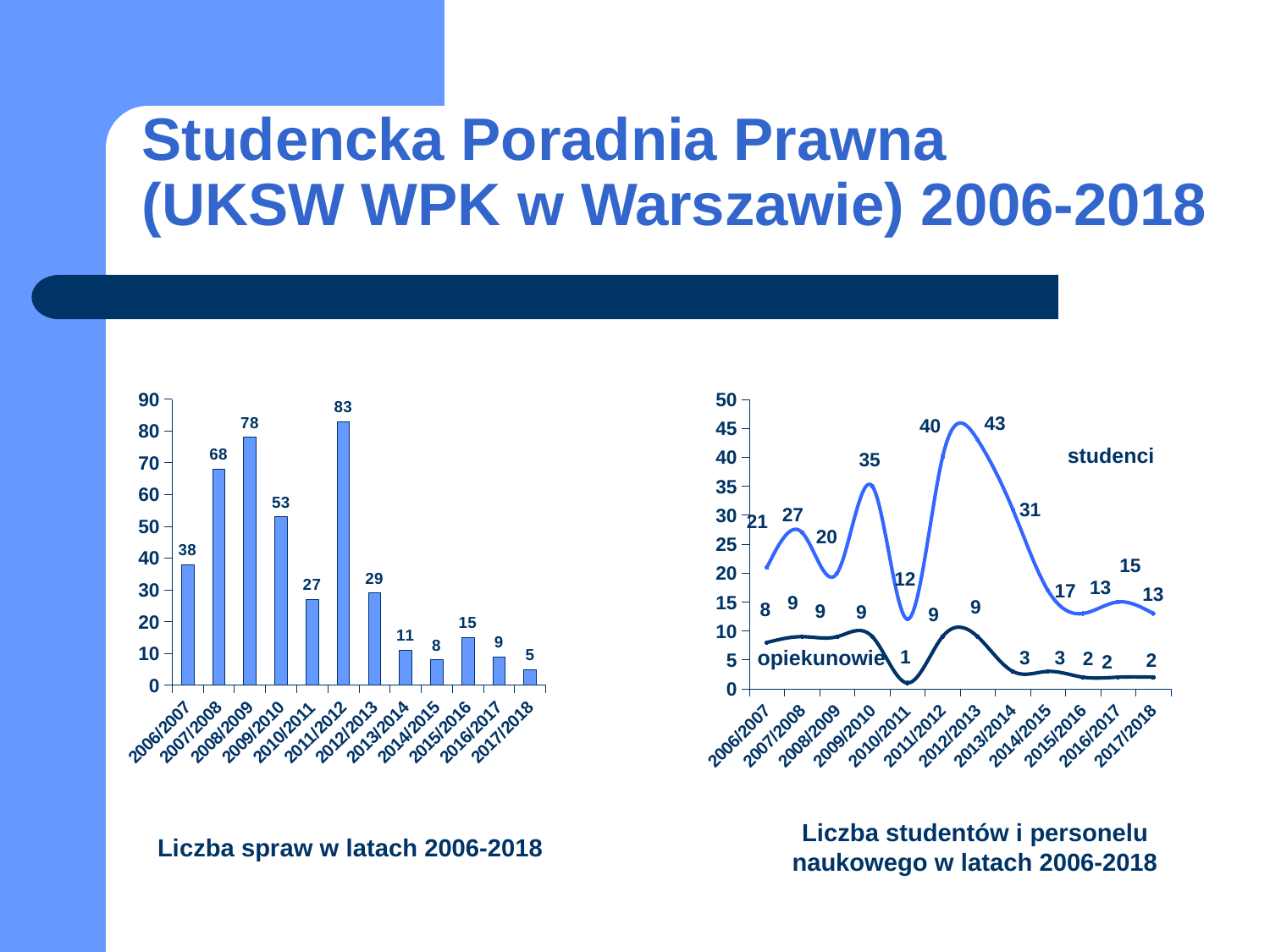
In the chart 'Liczba studentów i personelu naukowego w latach 2006-2018', which is larger in 2009/2010: studenci or opiekunowie? studenci What type of chart is 'Liczba spraw w latach 2006-2018'? bar chart In the chart 'Liczba spraw w latach 2006-2018', which year has the highest value? 2011/2012 In the chart 'Liczba studentów i personelu naukowego w latach 2006-2018', what is the difference between studenci and opiekunowie in 2013/2014? 28 In the chart 'Liczba studentów i personelu naukowego w latach 2006-2018', in which year is the studenci value highest? 2012/2013 What type of chart is 'Liczba studentów i personelu naukowego w latach 2006-2018'? line chart In the chart 'Liczba spraw w latach 2006-2018', what is the difference between the values for 2008/2009 and 2009/2010? 25 In the chart 'Liczba studentów i personelu naukowego w latach 2006-2018', what is the value for opiekunowie in 2010/2011? 1 In the chart 'Liczba spraw w latach 2006-2018', how many years are shown on the x axis? 12 In the chart 'Liczba spraw w latach 2006-2018', which year has the lowest value? 2017/2018 In the chart 'Liczba spraw w latach 2006-2018', what is the value for 2011/2012? 83 In the chart 'Liczba studentów i personelu naukowego w latach 2006-2018', what is the value for studenci in 2012/2013? 43